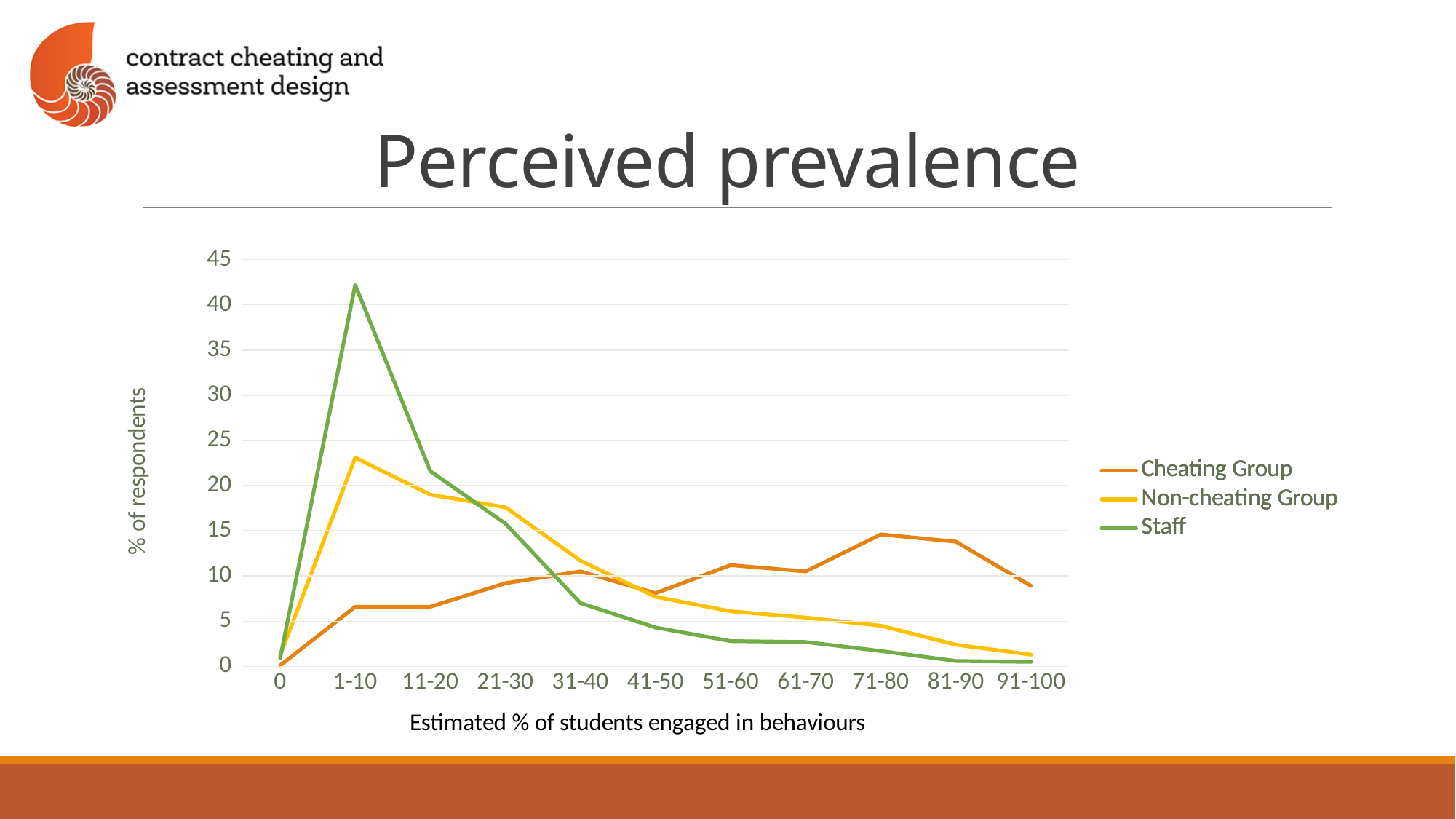
Is the Staff value for 1-10 greater or less than 40? greater Which x-axis category has the highest value for the Cheating Group series? 71-80 At 71-80, which is larger: the Cheating Group value or the Staff value? Cheating Group What kind of chart is shown on the slide? line chart How many categories are shown on the x axis? 11 Does the Staff series rise or fall from 1-10 to 91-100? fall Is the Non-cheating Group value for 1-10 greater or less than 20? greater Which series reaches the highest value anywhere on the chart? Staff At 21-30, which is larger: the Non-cheating Group value or the Cheating Group value? Non-cheating Group Is the Staff value for 31-40 greater or less than 10? less Which x-axis category has the highest value for the Staff series? 1-10 How many series does the legend list? 3